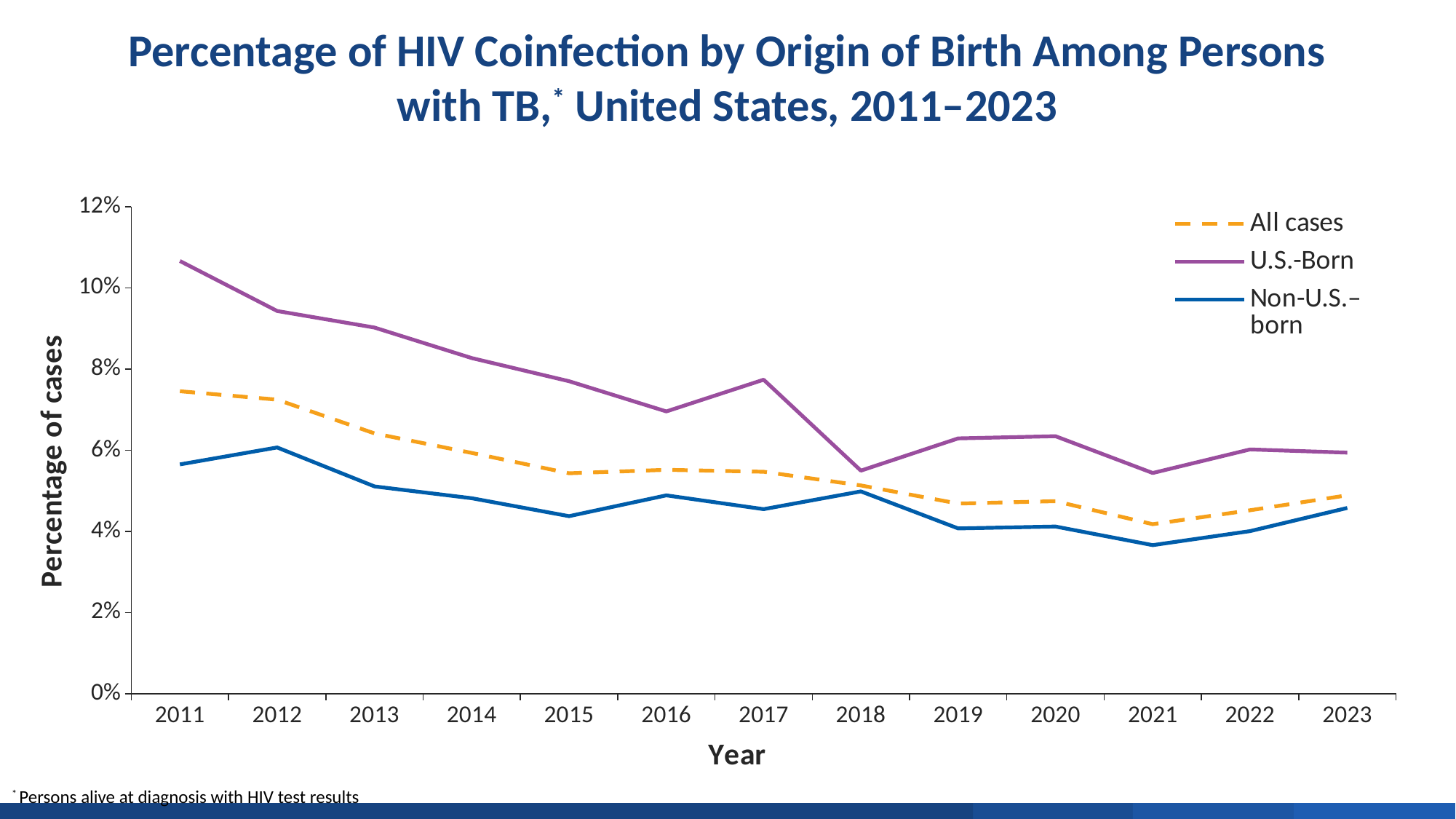
Which series is drawn with a dashed line? All cases In which year is the All cases percentage lowest? 2021 What kind of chart is shown on the slide? line chart In 2011, which is larger: the U.S.-Born percentage or the Non-U.S.-born percentage? U.S.-Born In which year is the Non-U.S.-born percentage lowest? 2021 Is the U.S.-Born value for 2018 greater or less than 6%? less In which year is the U.S.-Born percentage highest? 2011 Is the Non-U.S.-born value for 2021 greater or less than 4%? less How many years are plotted along the x axis? 13 Is the U.S.-Born value for 2011 greater or less than 10%? greater Does the All cases line generally rise or fall from 2011 to 2021? fall How many series does the legend list? 3